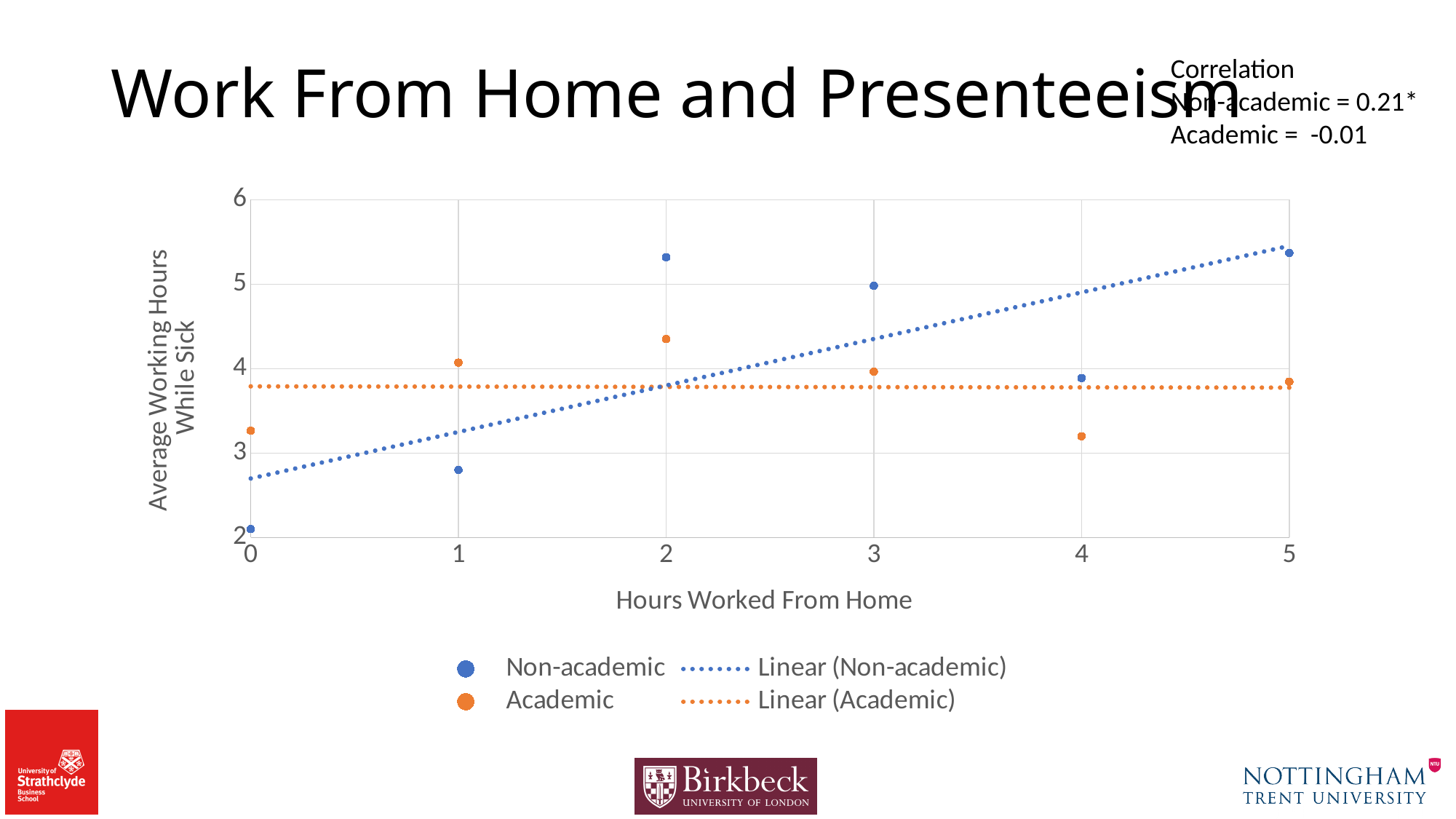
Is the Academic value at 4 hours worked from home greater or less than 4? less Is the Non-academic value at 1 hour worked from home greater or less than 3? less How many Non-academic data points are plotted on the chart? 6 What is the title of the x axis of the chart? Hours Worked From Home Does the Linear (Non-academic) trendline rise or fall as hours worked from home increase? rise At 0 hours worked from home, which series has the higher value, Non-academic or Academic? Academic What kind of chart is shown on the slide? scatter chart At 2 hours worked from home, which series has the higher value, Non-academic or Academic? Non-academic Is the Non-academic value at 2 hours worked from home greater or less than 5? greater How many entries does the chart legend list? 4 At which number of hours worked from home is the Non-academic value lowest? 0